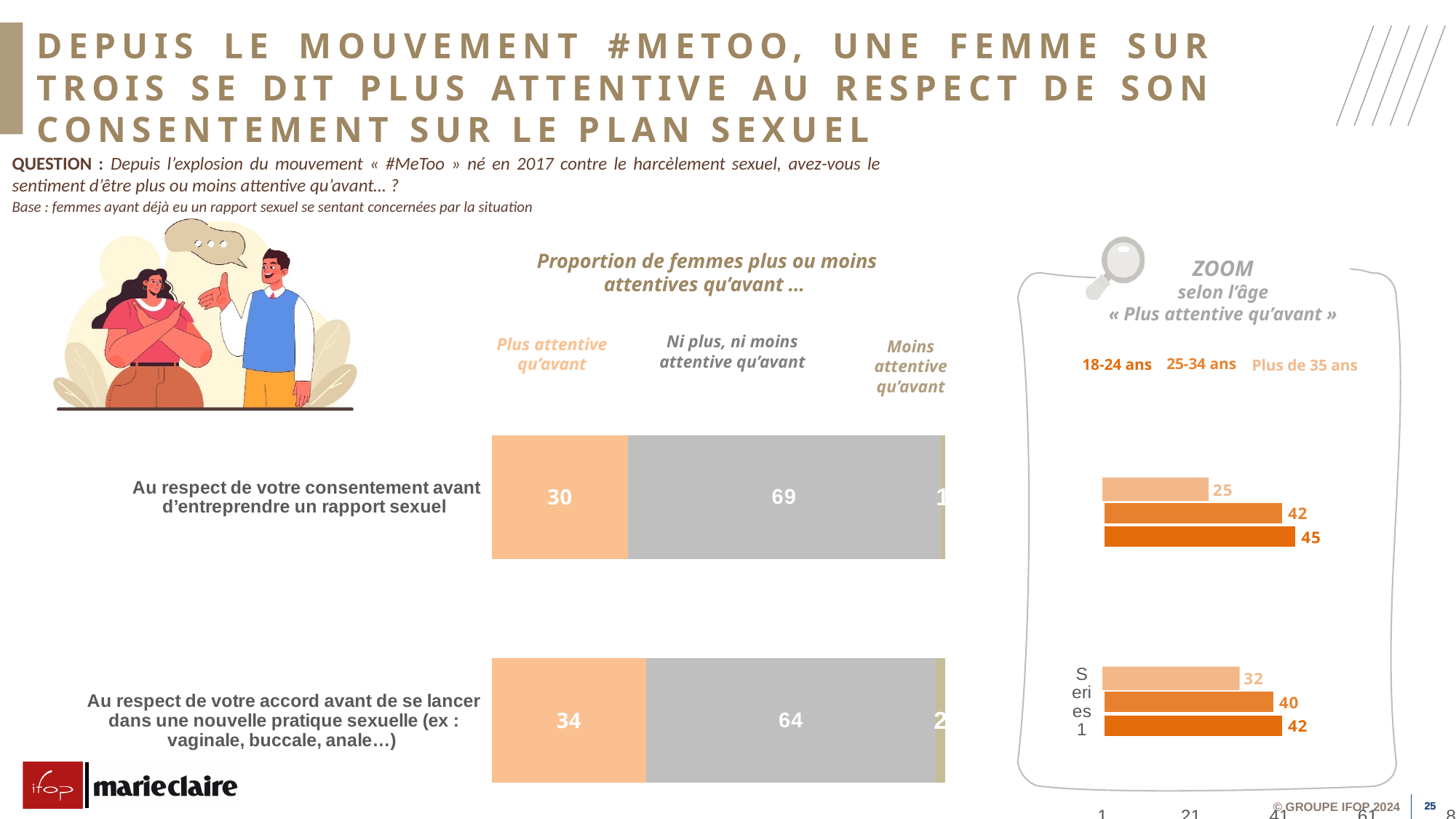
In the 'ZOOM selon l'âge' chart, which age group has the highest value for 'Au respect de votre consentement avant d'entreprendre un rapport sexuel'? 18-24 ans In the chart 'Proportion de femmes plus ou moins attentives qu'avant', how many series are shown? 3 In the 'ZOOM selon l'âge' chart, what is the value for 'Plus de 35 ans' for 'Au respect de votre accord avant de se lancer dans une nouvelle pratique sexuelle'? 32 In the chart 'Proportion de femmes plus ou moins attentives qu'avant', what is the value for 'Plus attentive qu'avant' for 'Au respect de votre consentement avant d'entreprendre un rapport sexuel'? 30 In the chart 'Proportion de femmes plus ou moins attentives qu'avant', what is the value for 'Moins attentive qu'avant' for 'Au respect de votre consentement avant d'entreprendre un rapport sexuel'? 1 In the 'ZOOM selon l'âge' chart, what is the difference between the '25-34 ans' and '18-24 ans' values for 'Au respect de votre consentement avant d'entreprendre un rapport sexuel'? 3 In the 'ZOOM selon l'âge' chart, which age group has the lowest value for 'Au respect de votre accord avant de se lancer dans une nouvelle pratique sexuelle'? Plus de 35 ans What kind of chart is 'Proportion de femmes plus ou moins attentives qu'avant'? Stacked bar chart In the chart 'Proportion de femmes plus ou moins attentives qu'avant', what is the total of the stacked bar for 'Au respect de votre accord avant de se lancer dans une nouvelle pratique sexuelle'? 100 In the 'ZOOM selon l'âge' chart, what is the value for '18-24 ans' for 'Au respect de votre consentement avant d'entreprendre un rapport sexuel'? 45 In the chart 'Proportion de femmes plus ou moins attentives qu'avant', what is the difference between the 'Plus attentive qu'avant' values of the two items? 4 In the chart 'Proportion de femmes plus ou moins attentives qu'avant', what is the value for 'Ni plus, ni moins attentive qu'avant' for 'Au respect de votre accord avant de se lancer dans une nouvelle pratique sexuelle'? 64